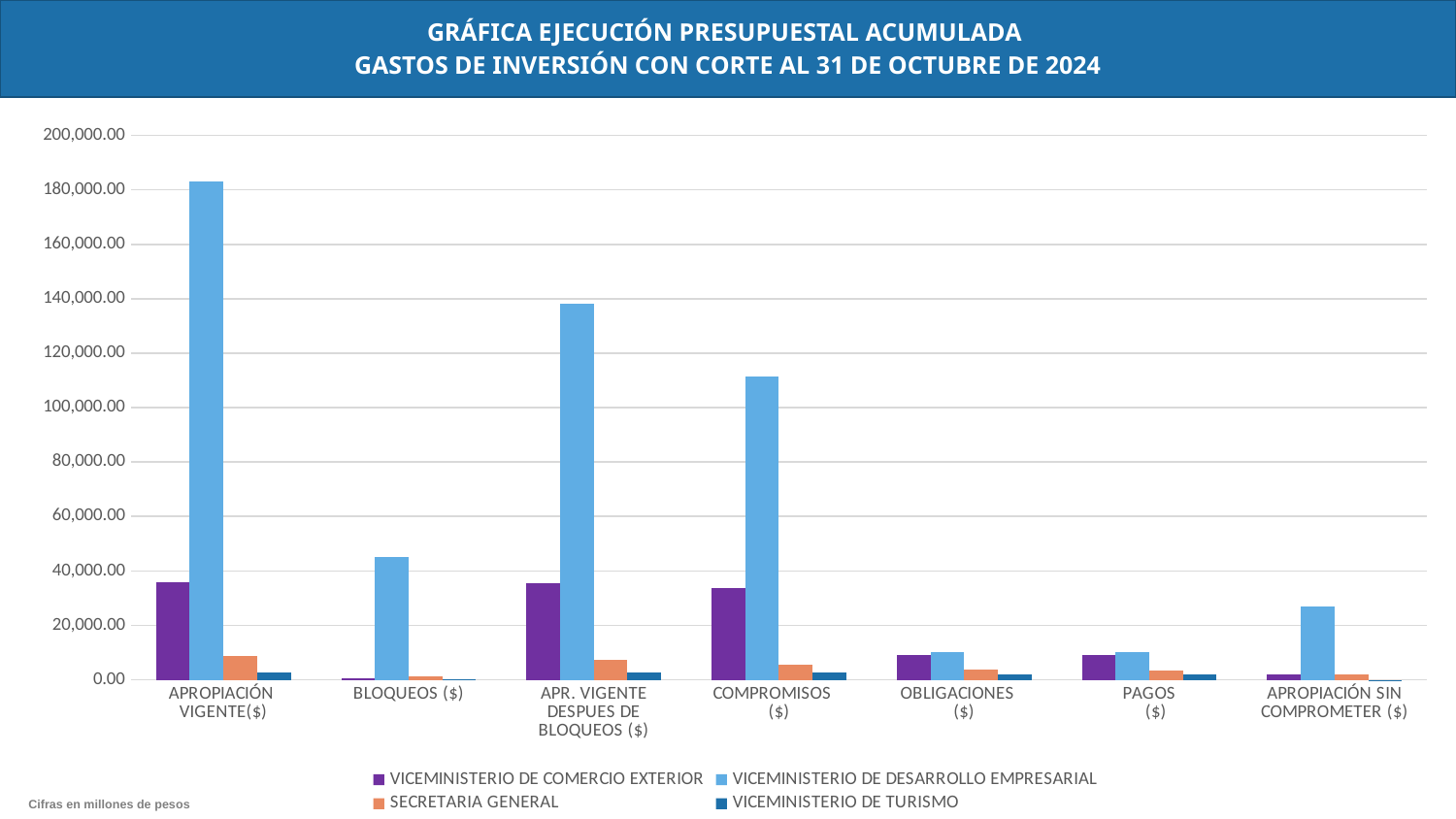
Is the value for VICEMINISTERIO DE DESARROLLO EMPRESARIAL in BLOQUEOS ($) greater or less than 40,000.00? greater Is the value for VICEMINISTERIO DE DESARROLLO EMPRESARIAL in COMPROMISOS ($) greater or less than 100,000.00? greater Is the value for VICEMINISTERIO DE COMERCIO EXTERIOR in APROPIACIÓN VIGENTE($) greater or less than 40,000.00? less In the APROPIACIÓN VIGENTE($) category, which is larger: VICEMINISTERIO DE COMERCIO EXTERIOR or SECRETARIA GENERAL? VICEMINISTERIO DE COMERCIO EXTERIOR In which category does VICEMINISTERIO DE DESARROLLO EMPRESARIAL reach its highest value? APROPIACIÓN VIGENTE($) How many series does the legend list? 4 What is the title of the chart? GRÁFICA EJECUCIÓN PRESUPUESTAL ACUMULADA GASTOS DE INVERSIÓN CON CORTE AL 31 DE OCTUBRE DE 2024 Which series has the tallest bar in the APROPIACIÓN VIGENTE($) category? VICEMINISTERIO DE DESARROLLO EMPRESARIAL What kind of chart is shown on the slide? bar chart How many categories are shown along the x axis? 7